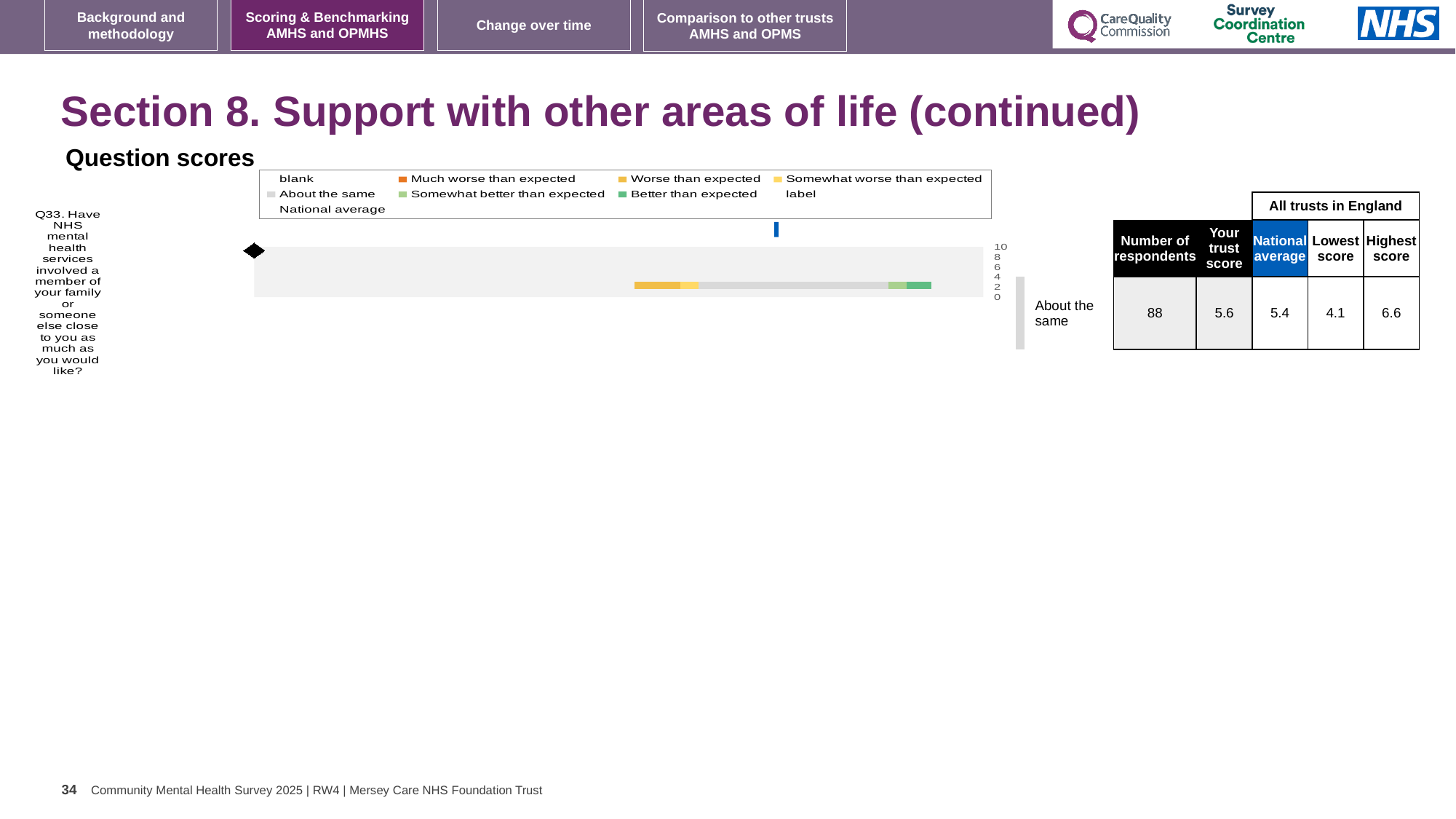
Which question is plotted in the Question scores chart? Q33. Have NHS mental health services involved a member of your family or someone else close to you as much as you would like? How many survey questions are plotted in the Question scores chart? 1 What benchmark category is the trust's Q33 score placed in? About the same What is the difference between the trust score and the National average for Q33? 0.2 Is the trust score for Q33 higher or lower than the National average? higher How many respondents answered Q33? 88 What is the difference between the Highest score and the Lowest score for Q33? 2.5 What is the National average score for Q33? 5.4 What is the Highest score among all trusts in England for Q33? 6.6 What is the 'Your trust score' for Q33? 5.6 What is the Lowest score among all trusts in England for Q33? 4.1 What kind of chart is shown under 'Question scores'? bar chart